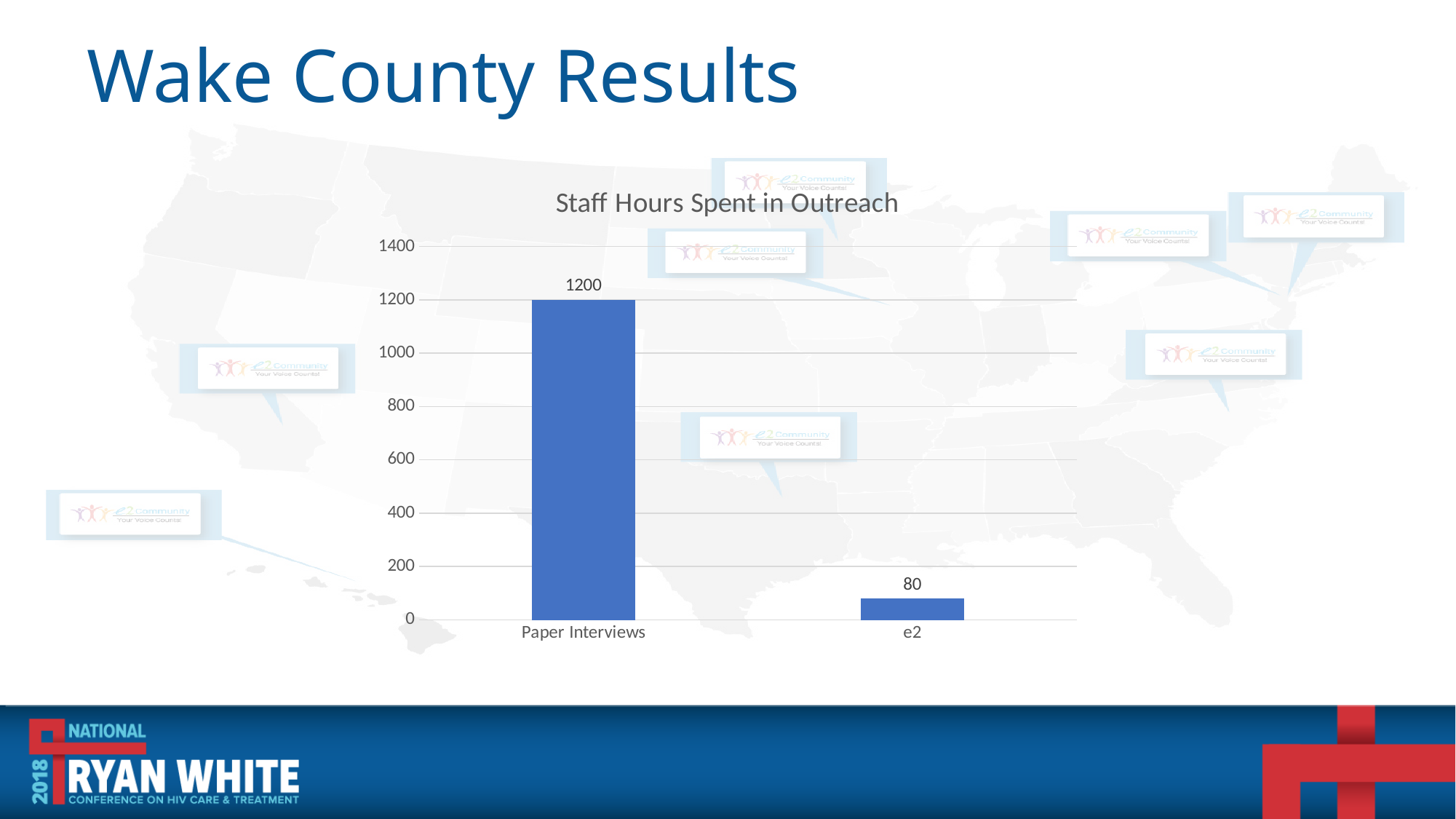
What is the difference between the values for Paper Interviews and e2? 1120 What is the title of the chart on the slide? Staff Hours Spent in Outreach What is the value for Paper Interviews in the Staff Hours Spent in Outreach chart? 1200 What is the highest value shown on the vertical axis of the chart? 1400 Which is larger, the value for Paper Interviews or the value for e2? Paper Interviews How many categories are shown in the Staff Hours Spent in Outreach chart? 2 Is the value for Paper Interviews greater or less than 1000? greater Is the value for e2 greater or less than 200? less What kind of chart is shown on the slide? bar chart What is the value for e2 in the Staff Hours Spent in Outreach chart? 80 Which category has the highest value in the Staff Hours Spent in Outreach chart? Paper Interviews Which category has the lowest value in the Staff Hours Spent in Outreach chart? e2